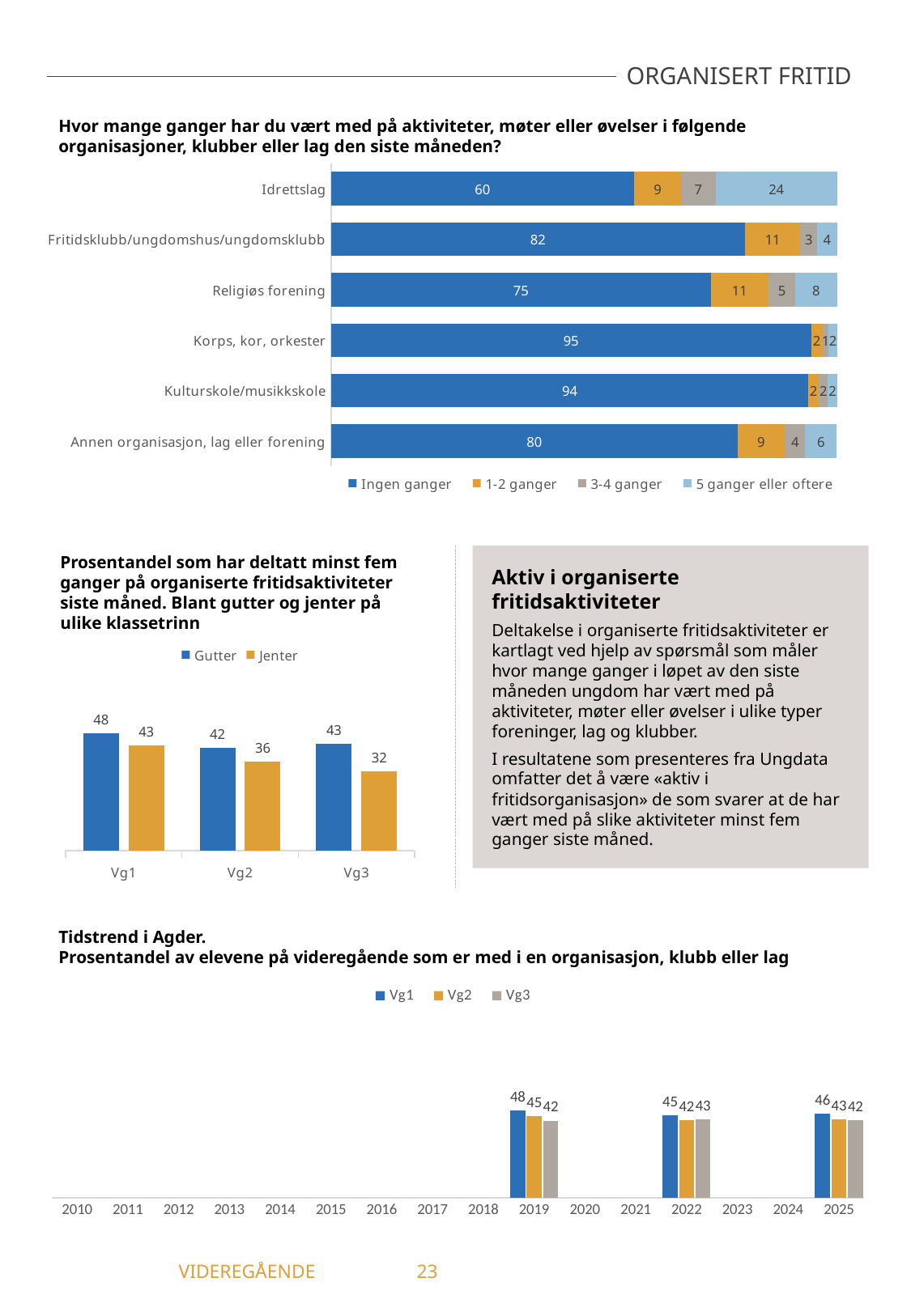
In the top chart about participation in organisations, clubs or teams, which category has the highest value for 'Ingen ganger'? Korps, kor, orkester What kind of chart is the 'Tidstrend i Agder' chart? Bar chart In the top chart about participation in organisations, clubs or teams, how many categories are shown? 6 In the top chart about participation in organisations, clubs or teams, what is the value for '5 ganger eller oftere' for Idrettslag? 24 In the top chart about participation in organisations, clubs or teams, what is the value for 'Ingen ganger' for Idrettslag? 60 In the chart 'Tidstrend i Agder', what is the value for Vg1 in 2019? 48 In the top chart about participation in organisations, clubs or teams, what is the difference between the 'Ingen ganger' values for Fritidsklubb/ungdomshus/ungdomsklubb and Religiøs forening? 7 In the chart 'Prosentandel som har deltatt minst fem ganger på organiserte fritidsaktiviteter siste måned', which is larger at Vg2, Gutter or Jenter? Gutter In the chart 'Prosentandel som har deltatt minst fem ganger på organiserte fritidsaktiviteter siste måned', what is the value for Jenter at Vg3? 32 In the chart 'Prosentandel som har deltatt minst fem ganger på organiserte fritidsaktiviteter siste måned', what is the difference between Gutter and Jenter at Vg3? 11 In the chart 'Tidstrend i Agder', which series has the lowest value in 2025? Vg3 In the top chart about participation in organisations, clubs or teams, how many series does the legend list? 4